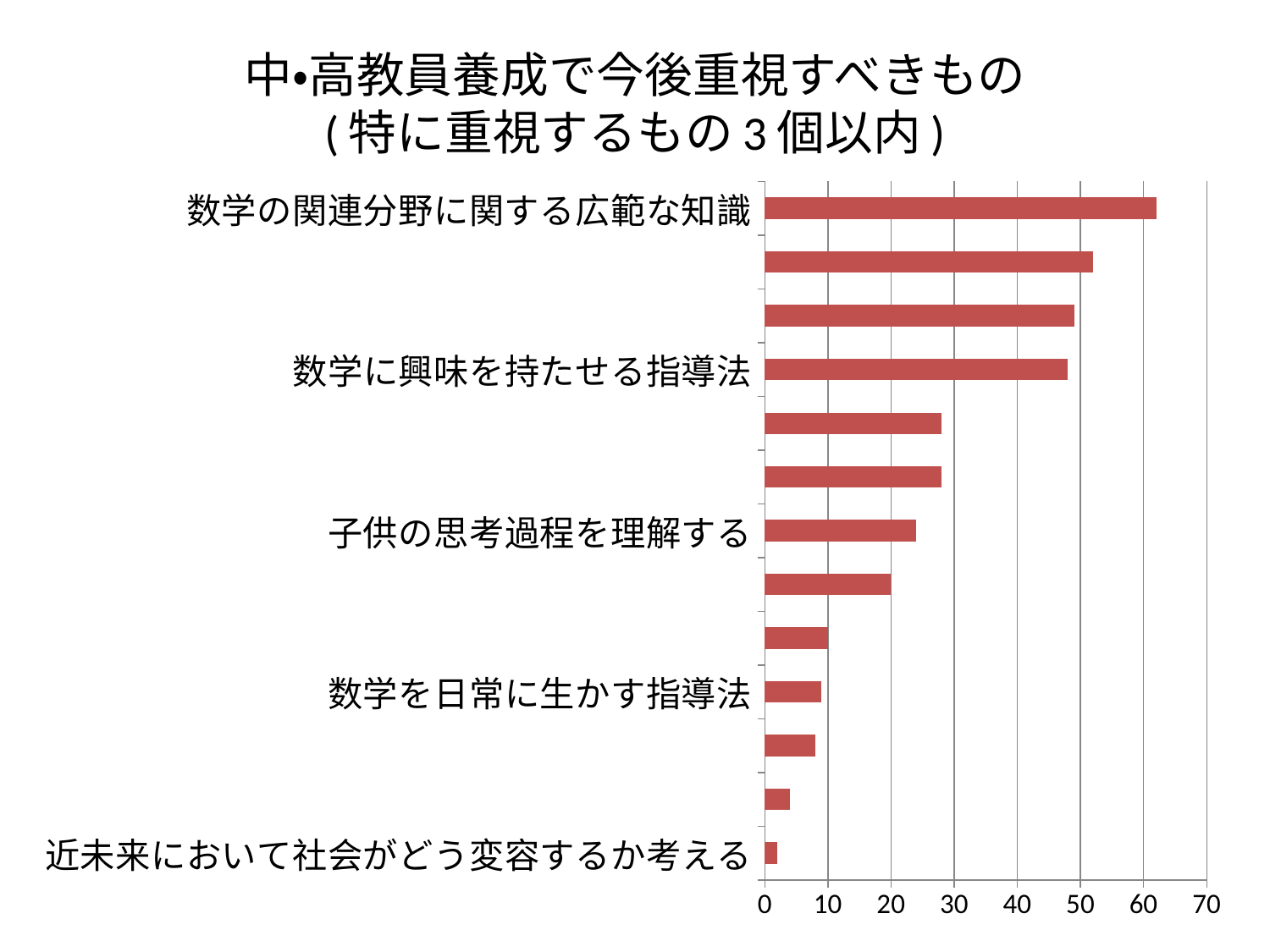
Is the value for 数学に興味を持たせる指導法 greater or less than 50? less Which category has the lowest value in the chart? 近未来において社会がどう変容するか考える Is the value for 数学の関連分野に関する広範な知識 greater or less than 60? greater Is the value for 子供の思考過程を理解する greater or less than 20? greater Which is larger, the value for 数学に興味を持たせる指導法 or the value for 子供の思考過程を理解する? 数学に興味を持たせる指導法 Which category has the highest value in the chart? 数学の関連分野に関する広範な知識 What kind of chart is shown on the slide? bar chart What is the maximum value shown on the horizontal axis? 70 How many bars are plotted in the chart? 13 Do the bar values increase or decrease going from the top of the chart to the bottom? decrease